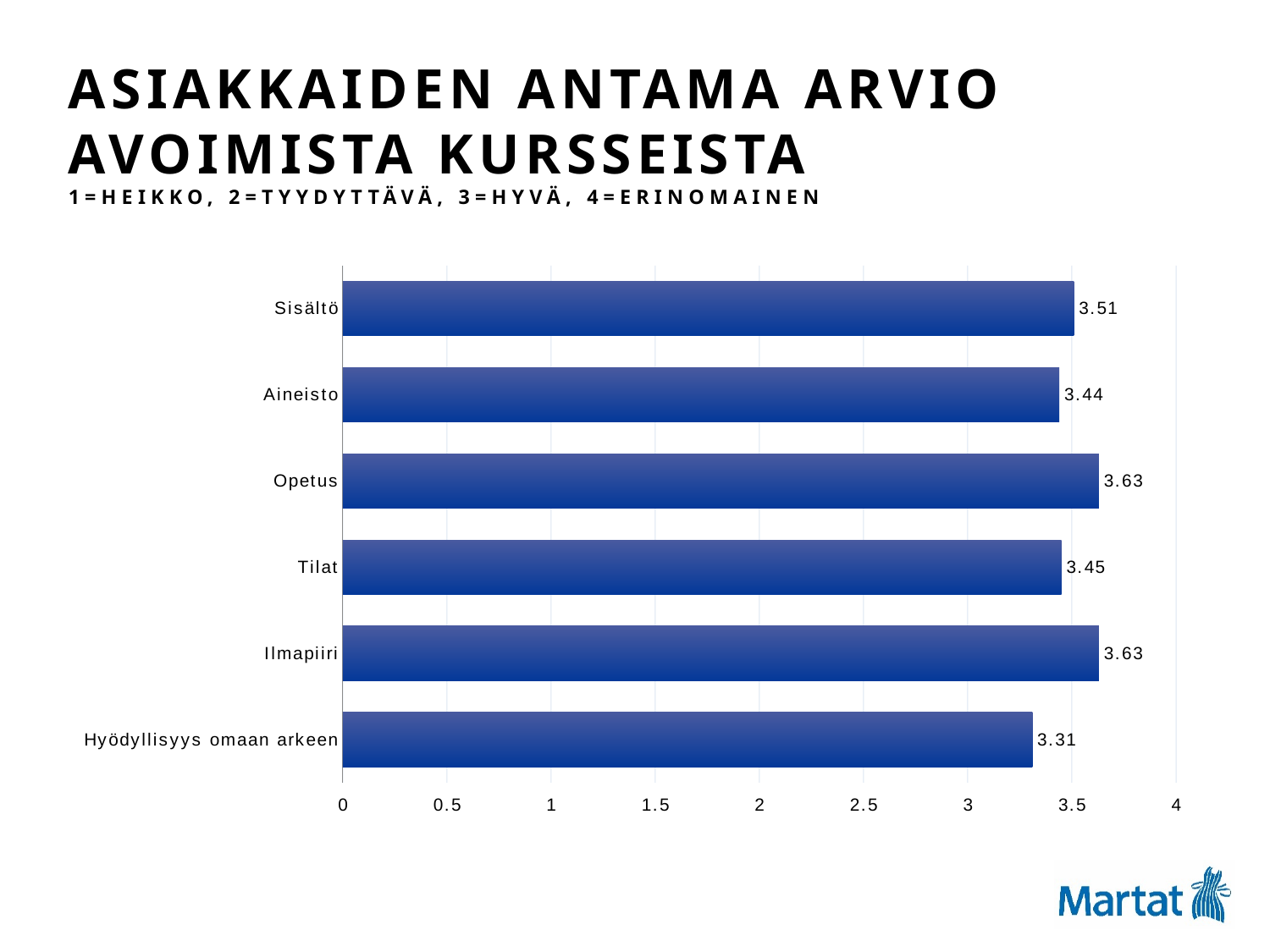
Which category has the lowest value? Hyödyllisyys omaan arkeen What is the value for Tilat? 3.45 What is the value for Opetus? 3.63 What kind of chart is shown on the slide? bar chart How many categories are shown in the chart? 6 What is the maximum value shown on the x axis? 4 Is the value for Ilmapiiri greater or less than 3.5? greater Which is larger, the value for Sisältö or the value for Hyödyllisyys omaan arkeen? Sisältö What is the value for Aineisto? 3.44 What is the value for Sisältö? 3.51 What is the difference between the values for Opetus and Hyödyllisyys omaan arkeen? 0.32 What is the value for Hyödyllisyys omaan arkeen? 3.31